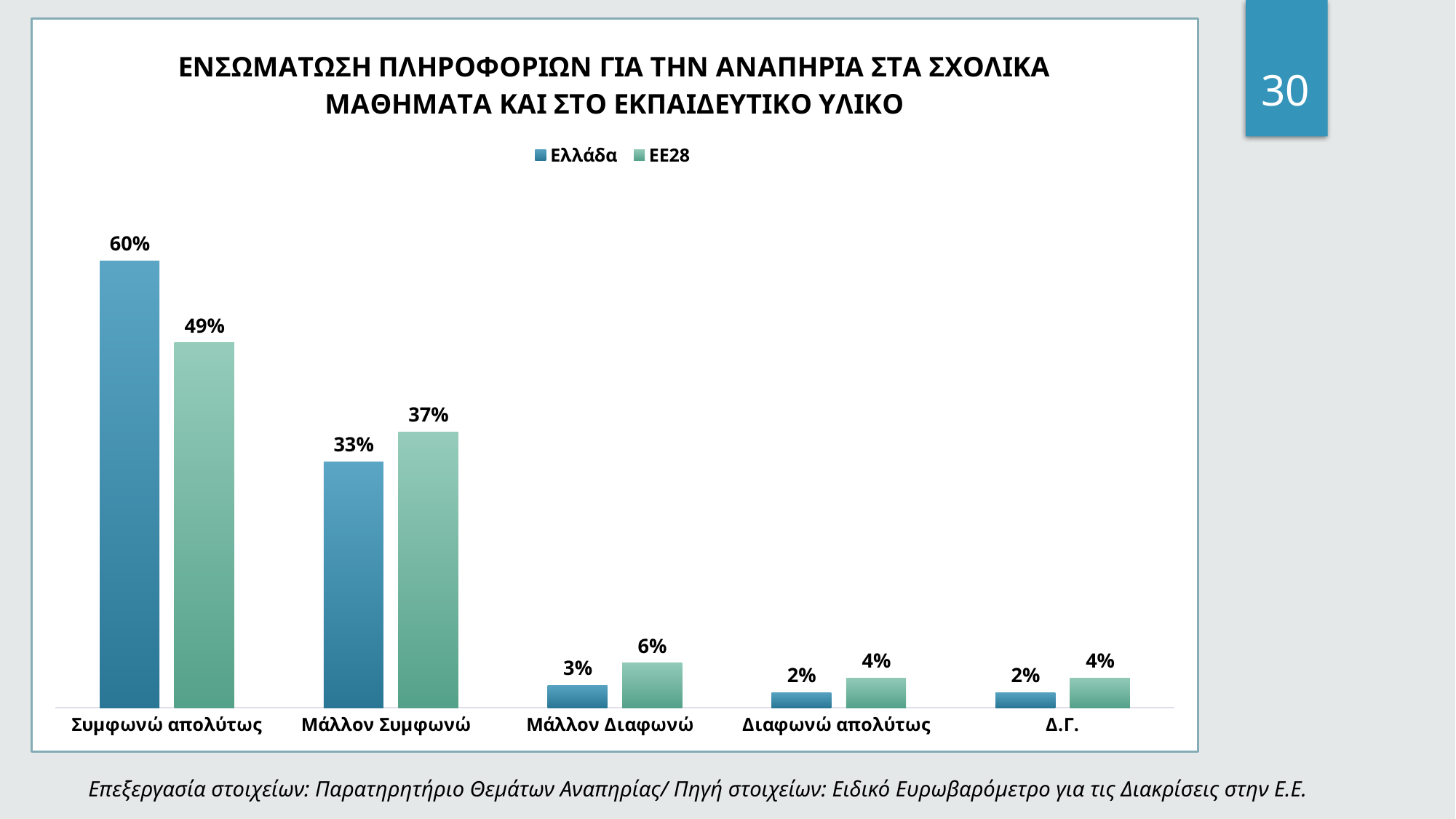
Which is larger in the Μάλλον Συμφωνώ category, Ελλάδα or ΕΕ28? ΕΕ28 Which category has the highest value for Ελλάδα? Συμφωνώ απολύτως What is the value for ΕΕ28 in the Μάλλον Συμφωνώ category? 37% Which category has the lowest value for ΕΕ28? Διαφωνώ απολύτως and Δ.Γ. (both 4%) How many categories are shown on the x axis? 5 What kind of chart is shown on the slide? Bar chart What is the value for ΕΕ28 in the Δ.Γ. category? 4% What is the value for Ελλάδα in the Συμφωνώ απολύτως category? 60% What is the difference between the ΕΕ28 and Ελλάδα values in the Μάλλον Συμφωνώ category? 4% How many series does the legend list? 2 What is the difference between the Ελλάδα and ΕΕ28 values in the Συμφωνώ απολύτως category? 11% What is the value for Ελλάδα in the Μάλλον Διαφωνώ category? 3%